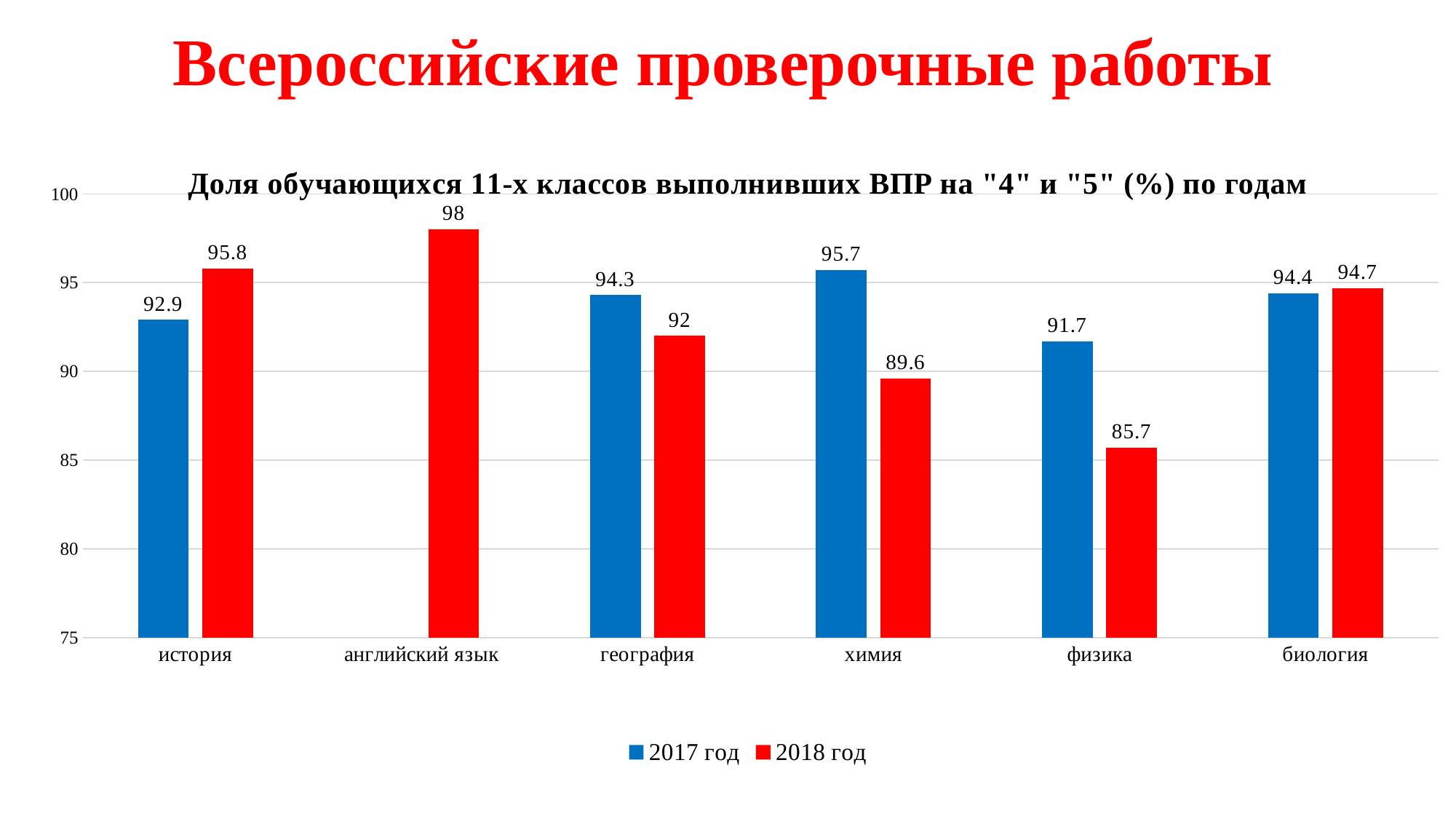
What kind of chart is shown on the slide? bar chart Which colour represents the 2018 год series? red Which is larger for география: the 2017 год value or the 2018 год value? 2017 год Which category has the highest value in the 2018 год series? английский язык What is the value for история in the 2017 год series? 92.9 Which category has the highest value in the 2017 год series? химия What is the value for физика in the 2018 год series? 85.7 How many categories are shown on the x axis? 6 What is the difference between the 2017 год and 2018 год values for химия? 6.1 How many series does the legend list? 2 Which category has the lowest value in the 2018 год series? физика What is the value for английский язык in the 2018 год series? 98